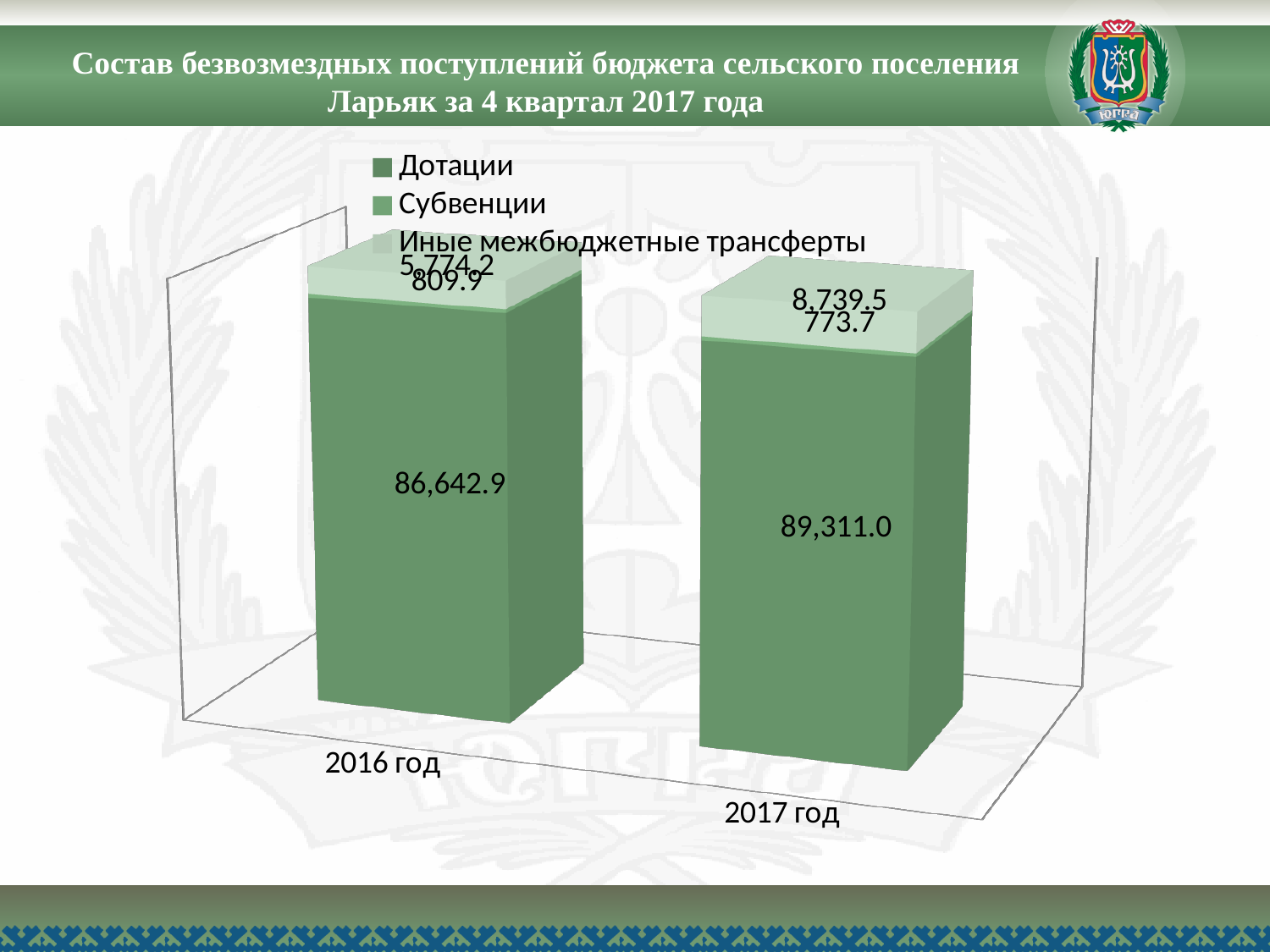
What is the value of Дотации for 2017 год? 89,311.0 What is the value of Дотации for 2016 год? 86,642.9 How many series does the legend list? 3 Which series is listed first in the legend? Дотации What is the total of the stacked bar for 2016 год? 93,227.0 Which year has the larger value for Дотации, 2016 год or 2017 год? 2017 год What type of chart is shown on the slide? stacked bar chart What is the total of the stacked bar for 2017 год? 98,824.2 How many categories (years) are shown on the x axis? 2 What is the value of Иные межбюджетные трансферты for 2017 год? 8,739.5 What is the value of Субвенции for 2017 год? 773.7 What is the difference between the Дотации values for 2017 год and 2016 год? 2,668.1